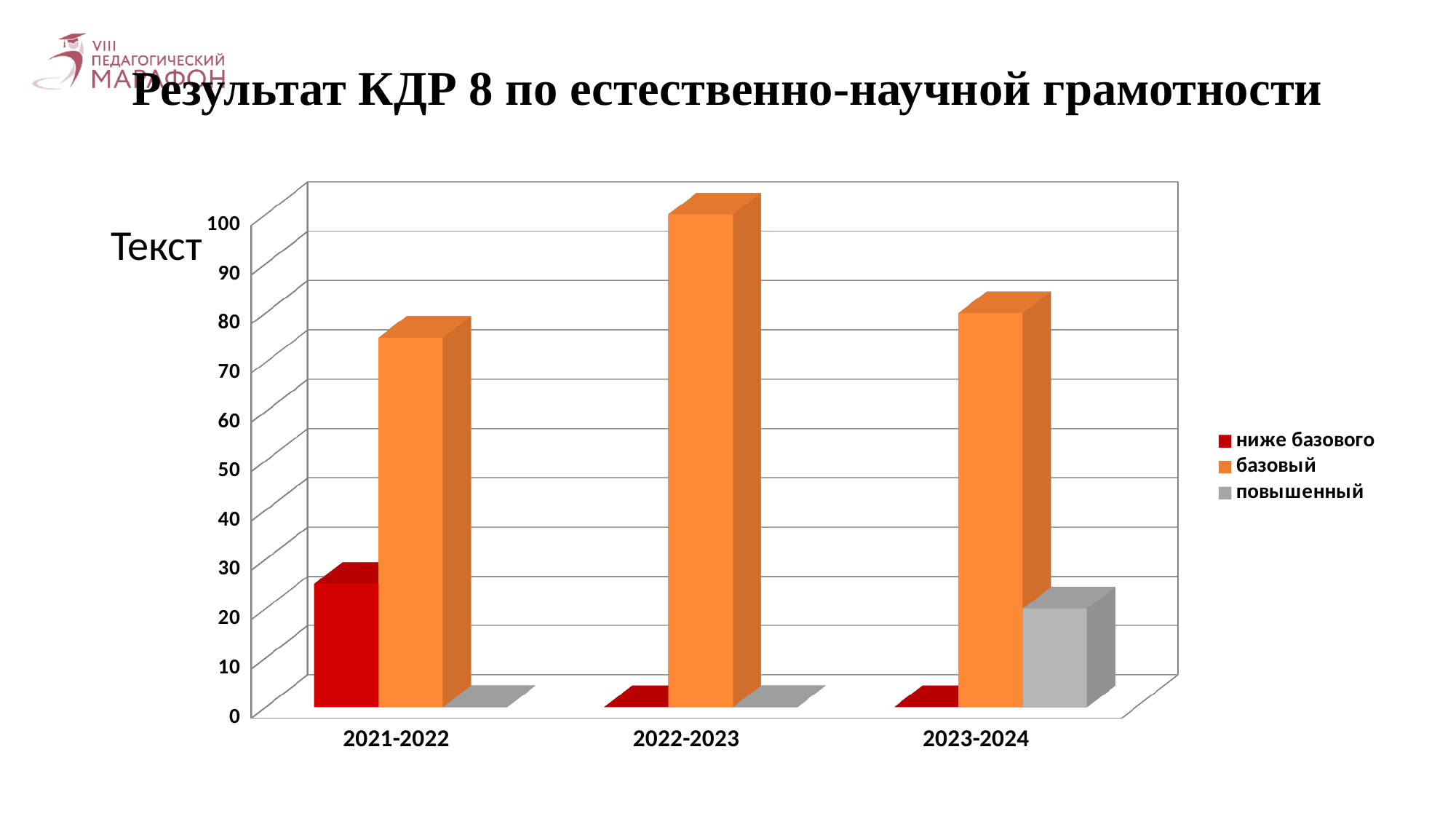
Does the 'базовый' value rise or fall from 2021-2022 to 2022-2023? rise Is the 'ниже базового' value for 2021-2022 greater or less than 40? less How many series does the chart legend list? 3 Which series are listed in the chart legend? ниже базового, базовый, повышенный In which academic year is the 'ниже базового' value the highest? 2021-2022 Is the 'повышенный' value for 2023-2024 greater or less than 30? less How many academic years are shown on the x axis of the chart? 3 In which academic year is the 'базовый' value the highest? 2022-2023 Is the 'базовый' value for 2021-2022 greater or less than 60? greater What kind of chart is shown on the slide? bar chart What is the title of the slide with the chart? Результат КДР 8 по естественно-научной грамотности In which academic year is the 'повышенный' value the highest? 2023-2024